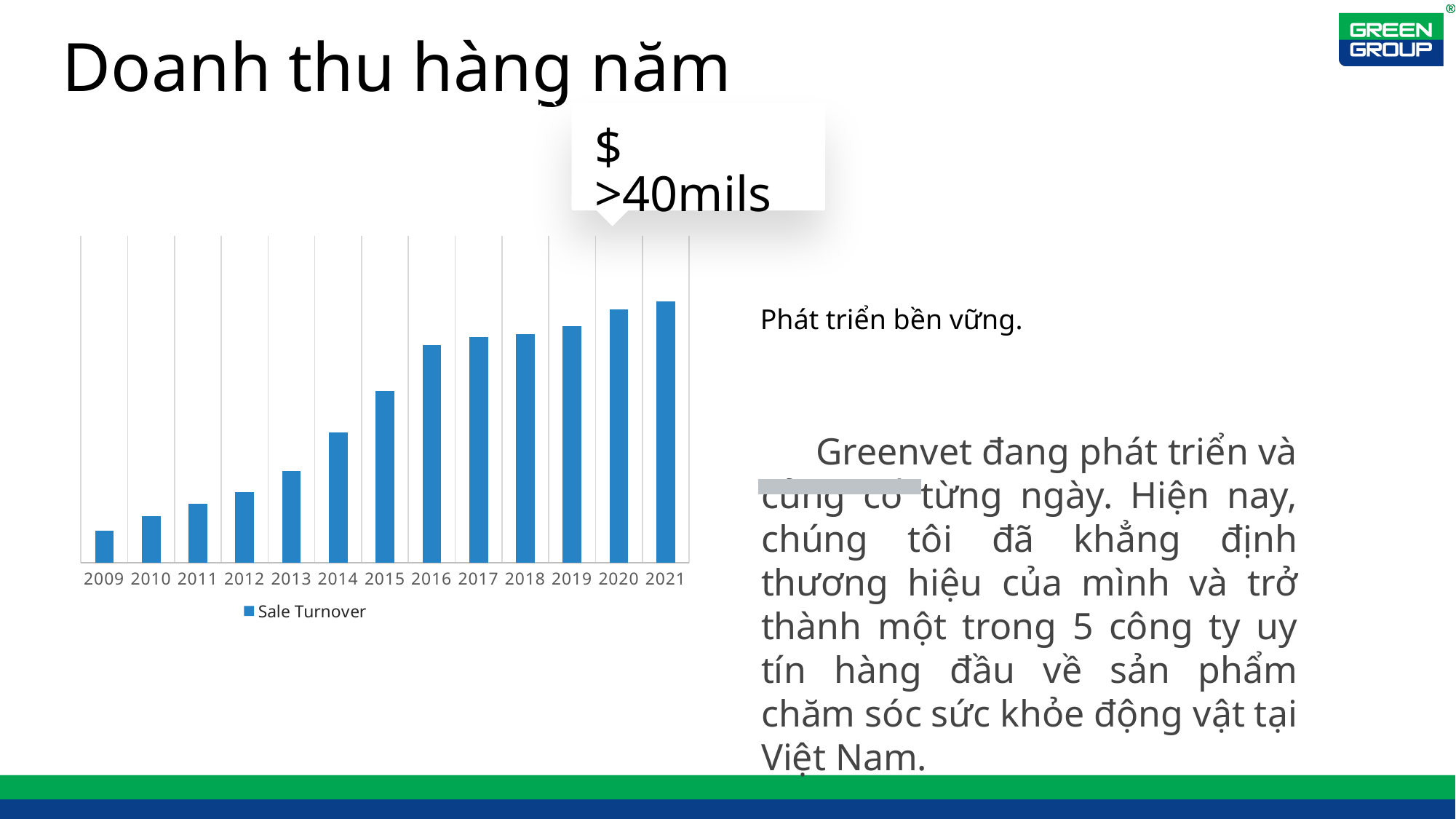
Which year has the lowest Sale Turnover bar? 2009 Do the Sale Turnover values rise or fall from 2009 to 2021? rise What is the name of the series shown in the chart legend? Sale Turnover Which year has the highest Sale Turnover bar? 2021 How many years are shown on the x axis of the chart? 13 Which year has the larger Sale Turnover bar, 2015 or 2019? 2019 Which year has the larger Sale Turnover bar, 2013 or 2011? 2013 How many series does the chart legend list? 1 Which year has the larger Sale Turnover bar, 2012 or 2010? 2012 What is the first year shown on the x axis of the chart? 2009 What kind of chart is shown on the slide? bar chart